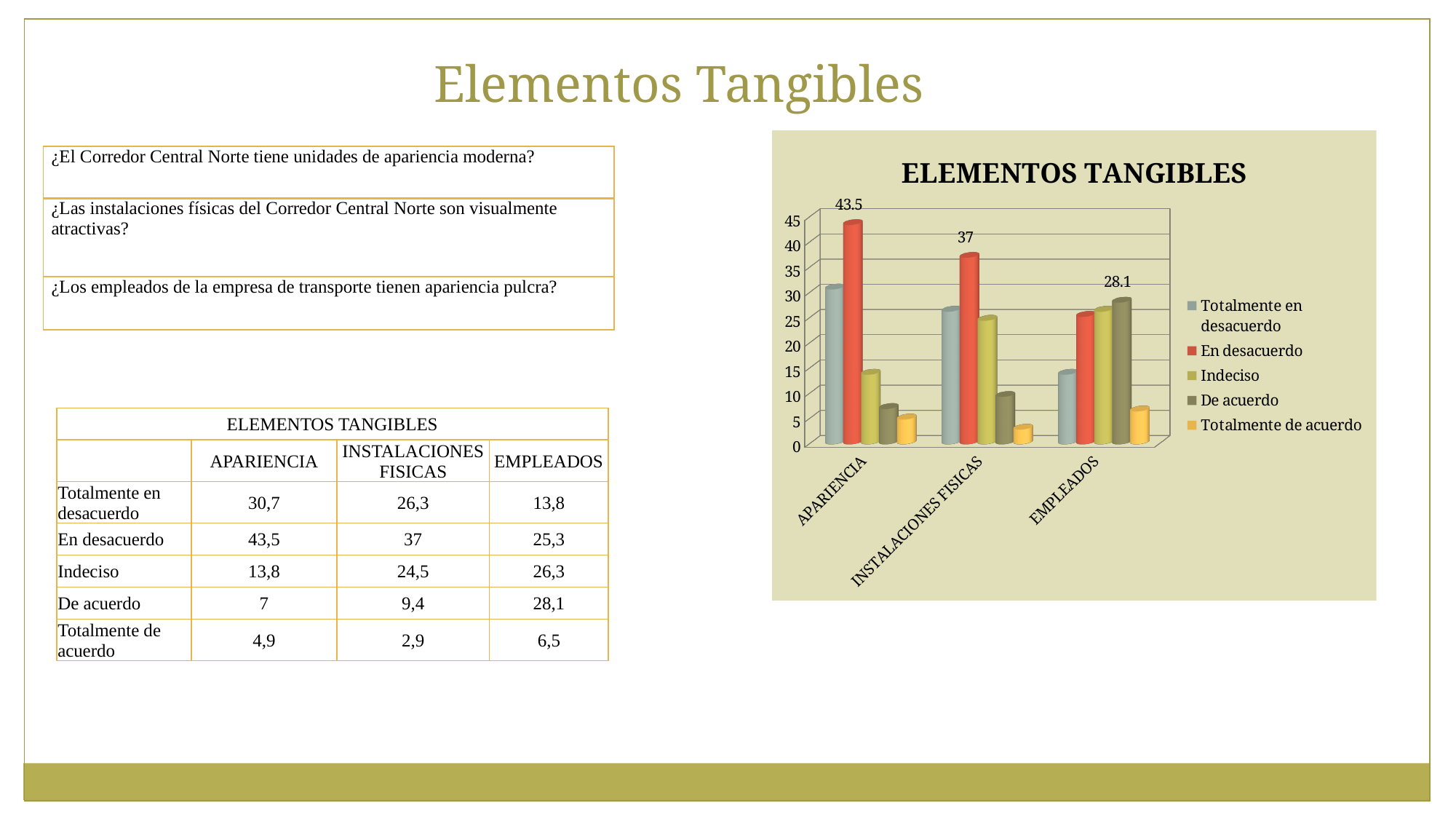
Does the En desacuerdo series rise or fall from APARIENCIA to EMPLEADOS? fall Is the Totalmente en desacuerdo value for APARIENCIA greater or less than 25? greater How many categories are shown on the x axis of the chart? 3 What is the value of the De acuerdo bar for EMPLEADOS? 28.1 What is the value of the En desacuerdo bar for INSTALACIONES FISICAS? 37 Is the Totalmente de acuerdo value for INSTALACIONES FISICAS greater or less than 5? less What is the difference between the En desacuerdo values for APARIENCIA and INSTALACIONES FISICAS? 6.5 Which is larger, the En desacuerdo value for APARIENCIA or for INSTALACIONES FISICAS? APARIENCIA What type of chart is shown on the slide? bar chart How many series does the chart legend list? 5 What is the value of the En desacuerdo bar for APARIENCIA? 43.5 Which category has the tallest bar in the chart? APARIENCIA